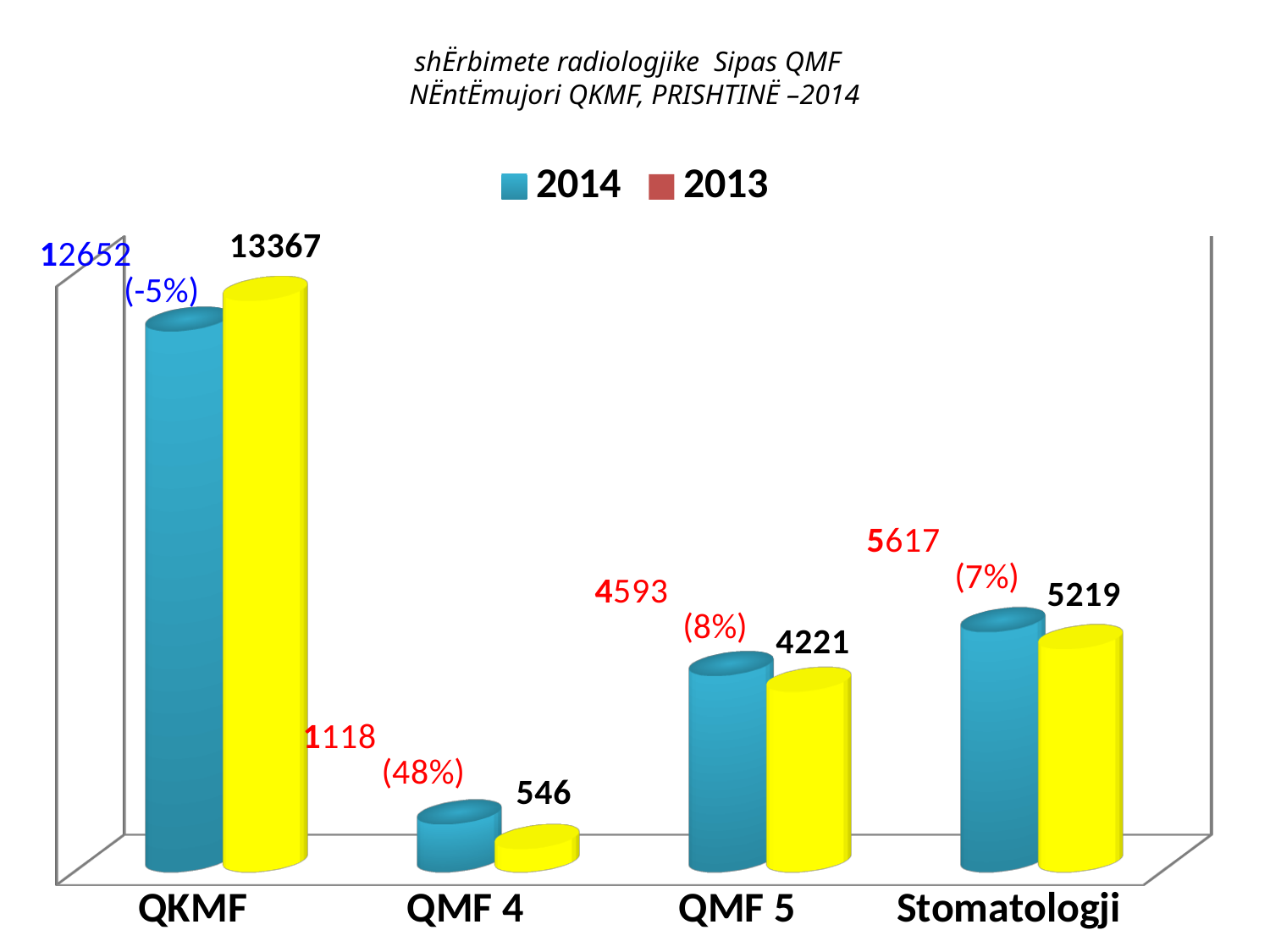
How many series does the legend list? 2 How many categories are shown on the x axis? 4 What is the difference between the 2013 and 2014 values for QKMF? 715 What kind of chart is shown on the slide? bar chart What is the 2014 value for Stomatologji? 5617 What is the 2013 value for QMF 5? 4221 Which category has the highest 2014 value? QKMF Which is larger for QMF 5, the 2014 value or the 2013 value? 2014 What is the 2014 value for QKMF? 12652 Which category has the lowest 2013 value? QMF 4 What is the 2013 value for QMF 4? 546 What percentage change is shown for QMF 4? 48%